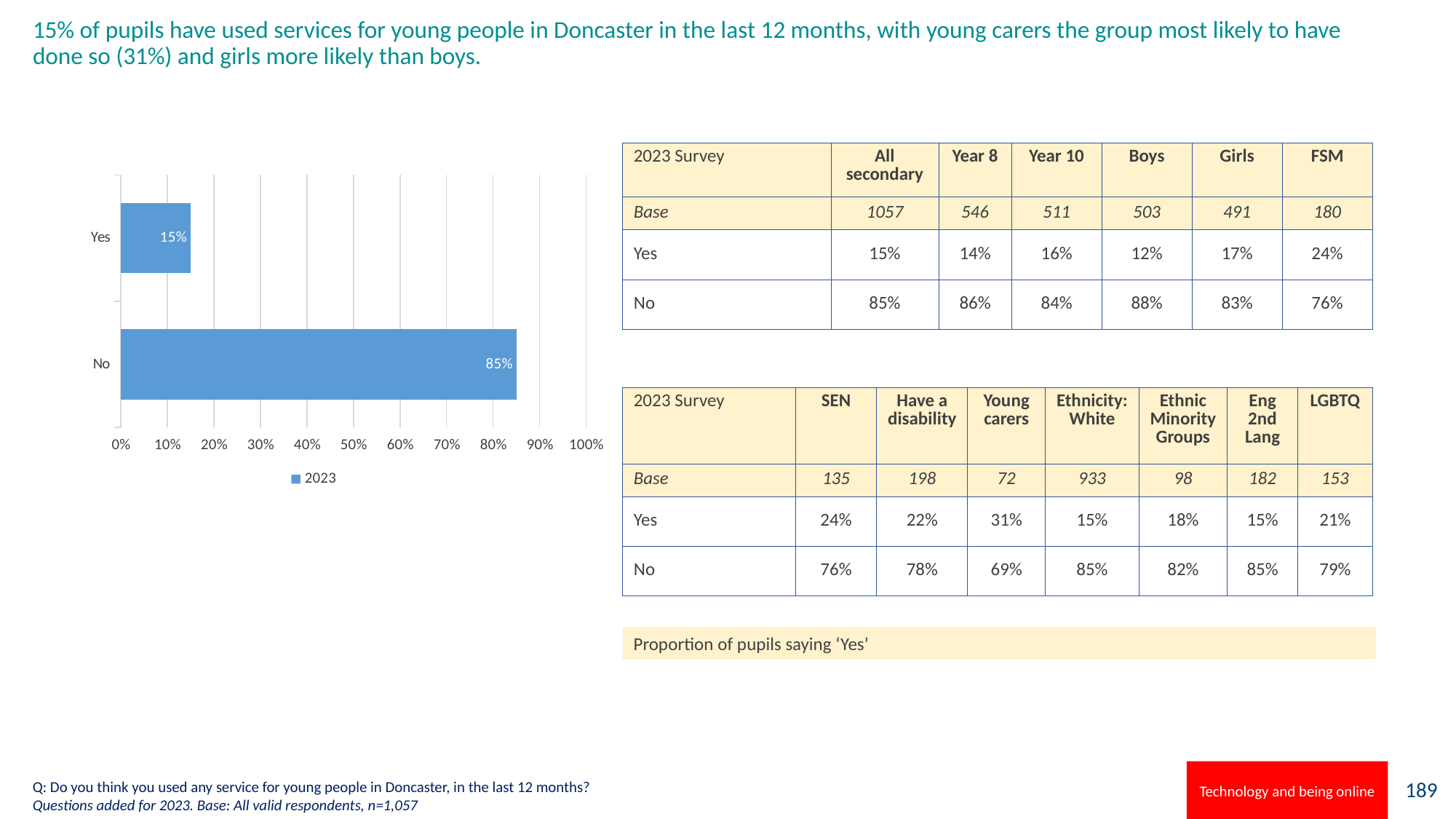
What kind of chart is shown on the slide? Bar chart Is the value for Yes in the bar chart greater or less than 20%? less What series name is shown in the legend of the bar chart? 2023 Is the value for No in the bar chart greater or less than 80%? greater How many series does the legend of the bar chart list? 1 How many categories are shown in the bar chart? 2 Which category has the lowest value in the bar chart? Yes What is the value for Yes in the bar chart? 15% What is the value for No in the bar chart? 85% Which category has the highest value in the bar chart? No Which is larger in the bar chart, Yes or No? No What is the difference between the No and Yes values in the bar chart? 70%